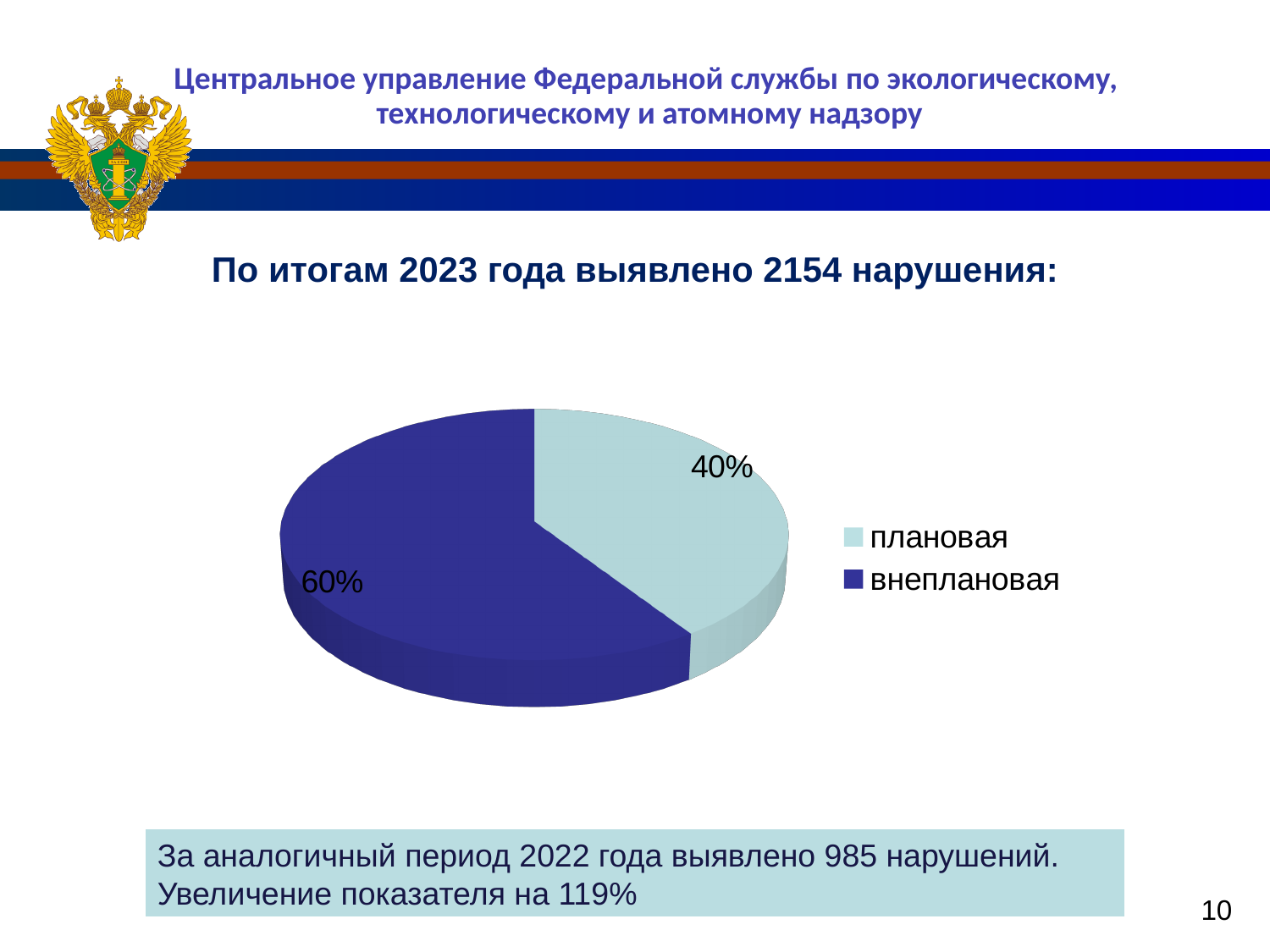
How many slices does the pie chart have? 2 Which colour is used for the 'внеплановая' slice? dark blue What share of the pie does the 'внеплановая' slice represent? 60% How many entries does the legend list? 2 Which is larger, the 'плановая' slice or the 'внеплановая' slice? внеплановая What is the difference in percentage points between the 'внеплановая' and 'плановая' slices? 20% Which category has the smallest slice of the pie? плановая Which colour is used for the 'плановая' slice? light blue What share of the pie does the 'плановая' slice represent? 40% What kind of chart is shown on the slide? pie chart Which category has the largest slice of the pie? внеплановая